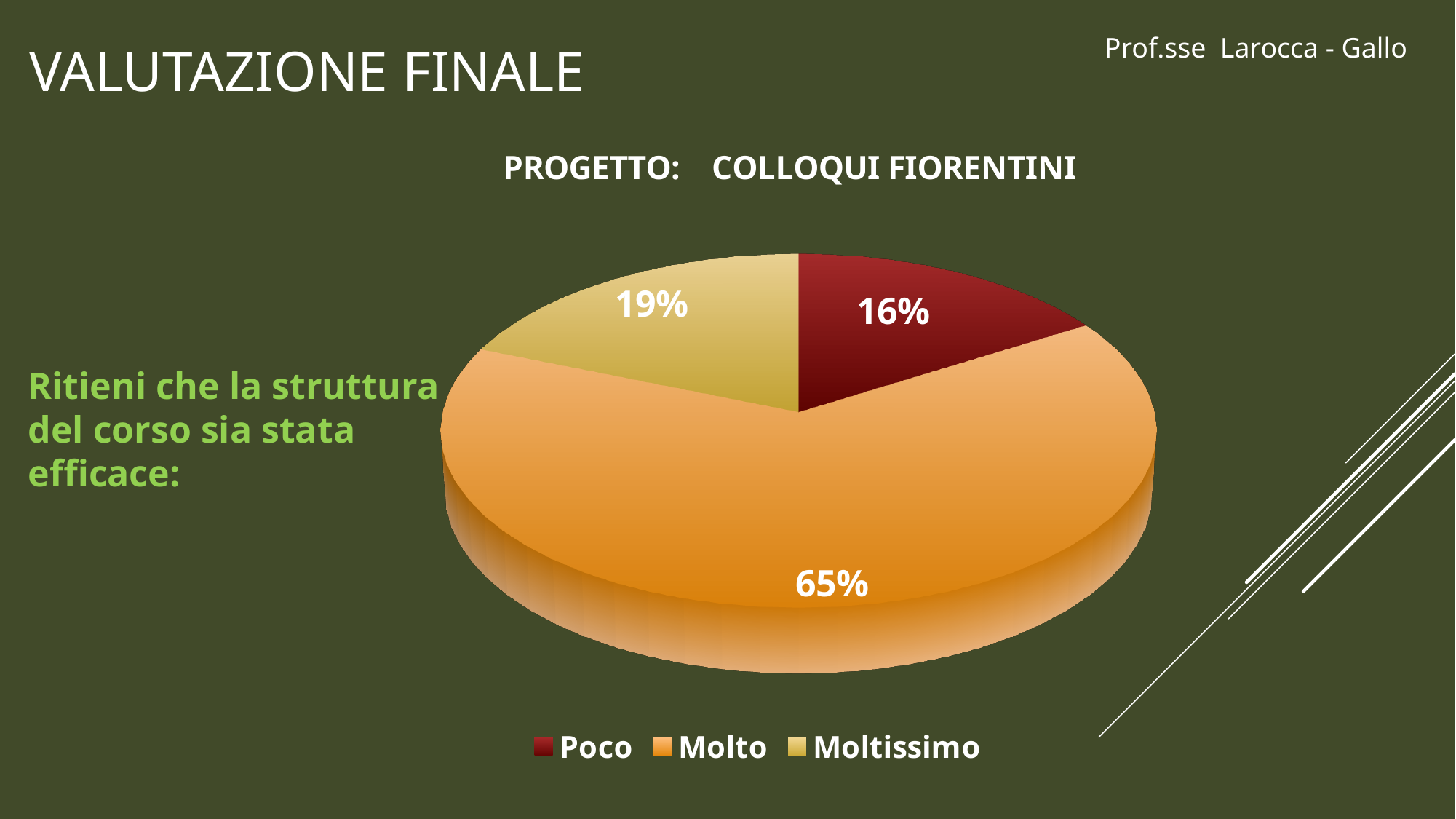
What share of the pie does the Poco slice represent? 16% Which category has the largest slice of the pie? Molto What colour is the Poco slice in the pie chart? Dark red What is the difference in percentage points between the Moltissimo and Poco slices? 3 How many slices does the pie chart have? 3 What share of the pie does the Molto slice represent? 65% Which category has the smallest slice of the pie? Poco Which slice is larger, Poco or Moltissimo? Moltissimo What kind of chart is shown on the slide? Pie chart What is the difference in percentage points between the Molto and Moltissimo slices? 46 What share of the pie does the Moltissimo slice represent? 19% What is the title of the chart? PROGETTO: COLLOQUI FIORENTINI